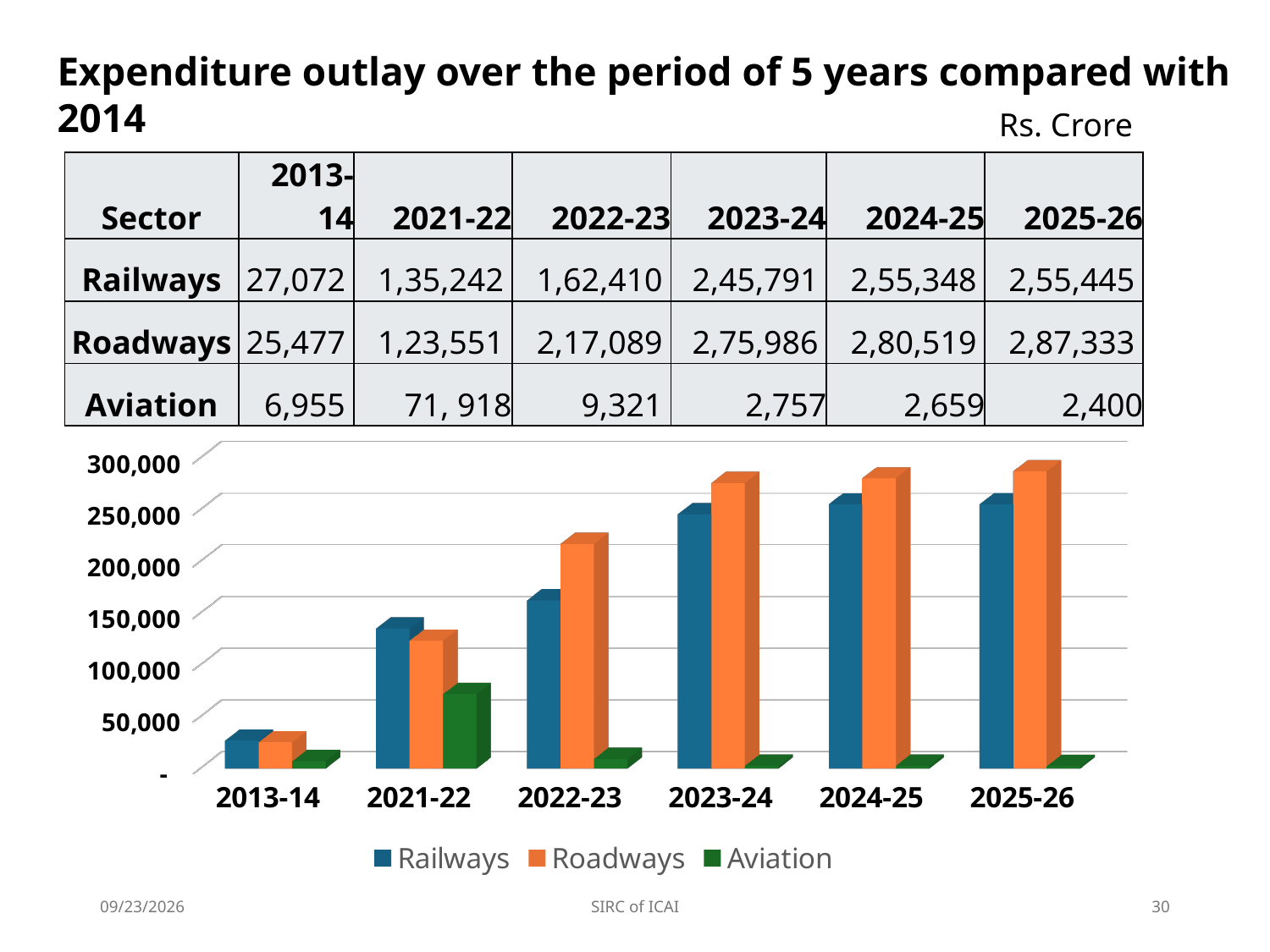
In which year is the Railways outlay the lowest? 2013-14 What is the Aviation expenditure outlay for 2013-14? 6,955 How many series does the chart legend list? 3 Which is larger in 2022-23, the Railways outlay or the Roadways outlay? Roadways Is the Roadways bar for 2024-25 greater or less than 250,000? greater What is the Railways expenditure outlay for 2022-23? 1,62,410 In which year is the Roadways outlay the highest? 2025-26 What is the Roadways expenditure outlay for 2025-26? 2,87,333 What is the difference between the Roadways and Railways outlays in 2023-24? 30,195 Does the Railways outlay rise or fall from 2013-14 to 2025-26? rise What type of chart is shown on the slide? bar chart How many year categories are shown on the x axis of the chart? 6